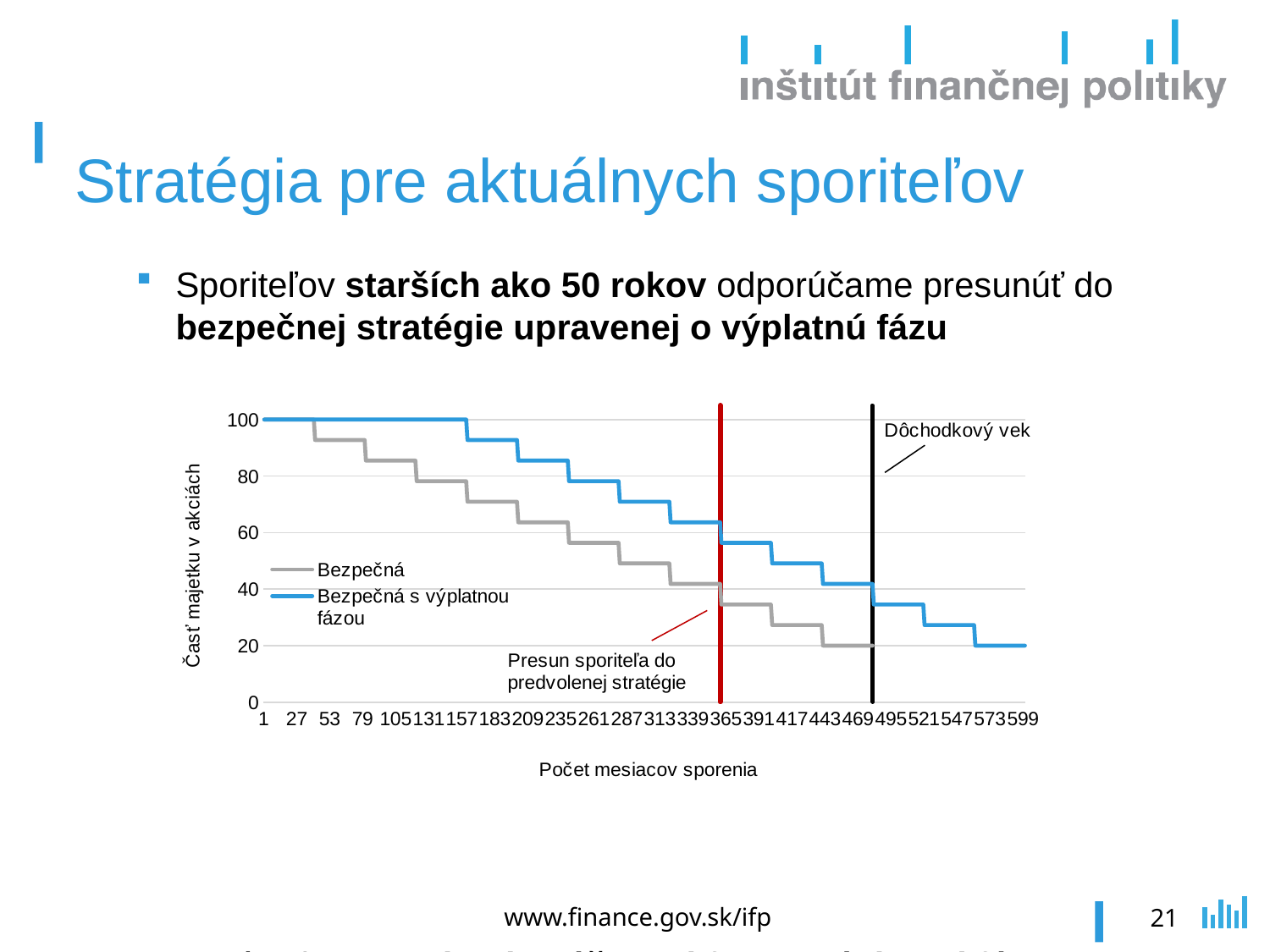
What is the value of the Bezpečná s výplatnou fázou series at month 599? 20 What is the value of the Bezpečná series at month 1? 100 How many series does the chart legend list? 2 What is the title of the chart's x axis? Počet mesiacov sporenia What are the two series named in the chart legend? Bezpečná; Bezpečná s výplatnou fázou Do the values of the Bezpečná series rise or fall as the number of months increases? fall Is the value for the Bezpečná s výplatnou fázou series at month 521 greater or less than 40? less What is the value of the Bezpečná s výplatnou fázou series at month 1? 100 At month 365, which series has the higher value, Bezpečná or Bezpečná s výplatnou fázou? Bezpečná s výplatnou fázou Is the value for the Bezpečná series at month 443 greater or less than 40? less What kind of chart is shown on the slide? line chart